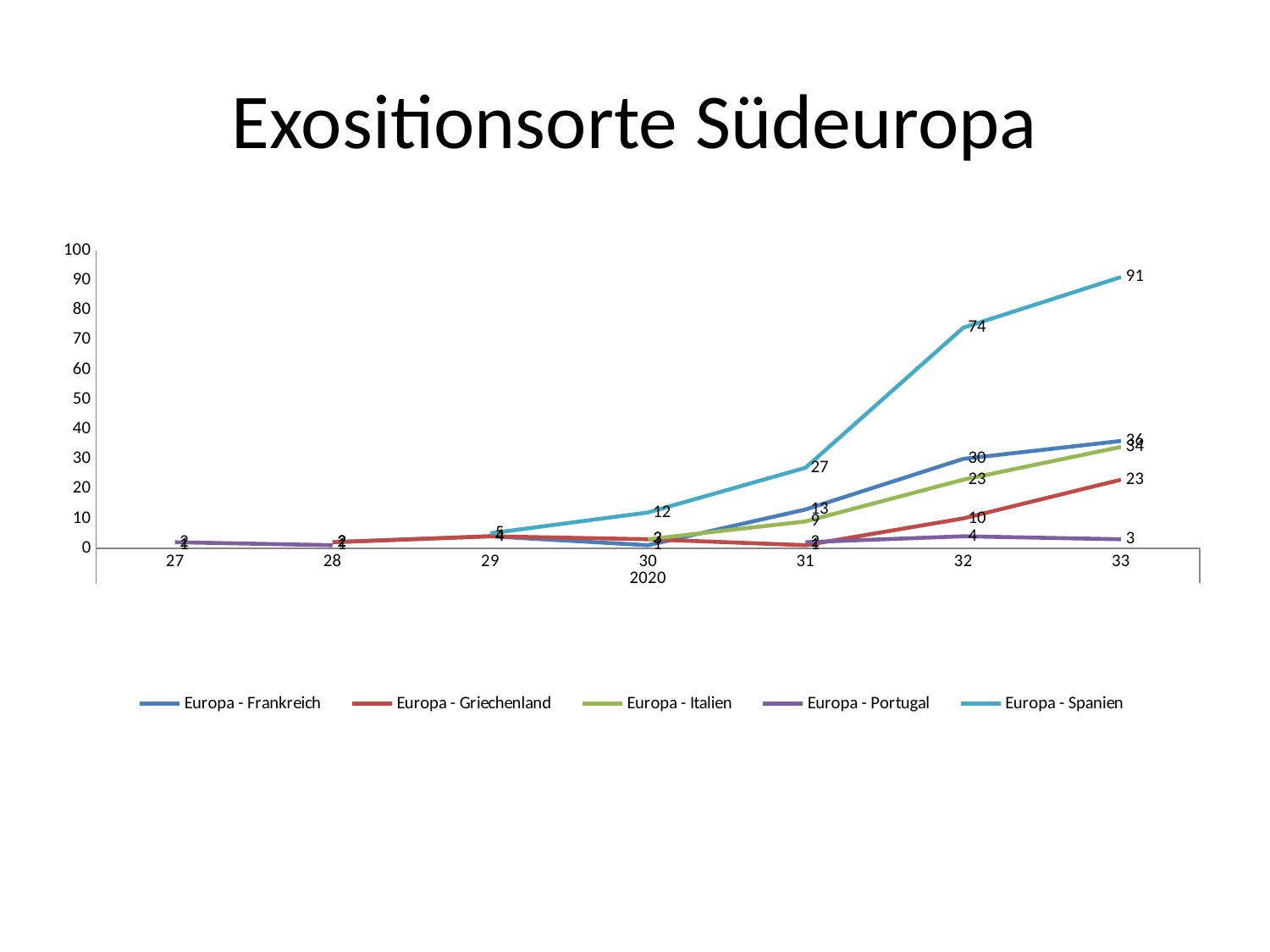
Which series has the highest value at week 33? Europa - Spanien What is the value for Europa - Portugal at week 33? 3 How many series does the legend list? 5 What is the value for Europa - Spanien at week 33? 91 What kind of chart is shown on the slide? line chart What is the value for Europa - Frankreich at week 32? 30 What is the value for Europa - Spanien at week 31? 27 At week 32, which is larger: Europa - Frankreich or Europa - Italien? Europa - Frankreich What is the difference between the Europa - Spanien values at week 33 and week 32? 17 What is the value for Europa - Griechenland at week 33? 23 What is the value for Europa - Spanien at week 32? 74 How many weeks are shown on the x axis? 7